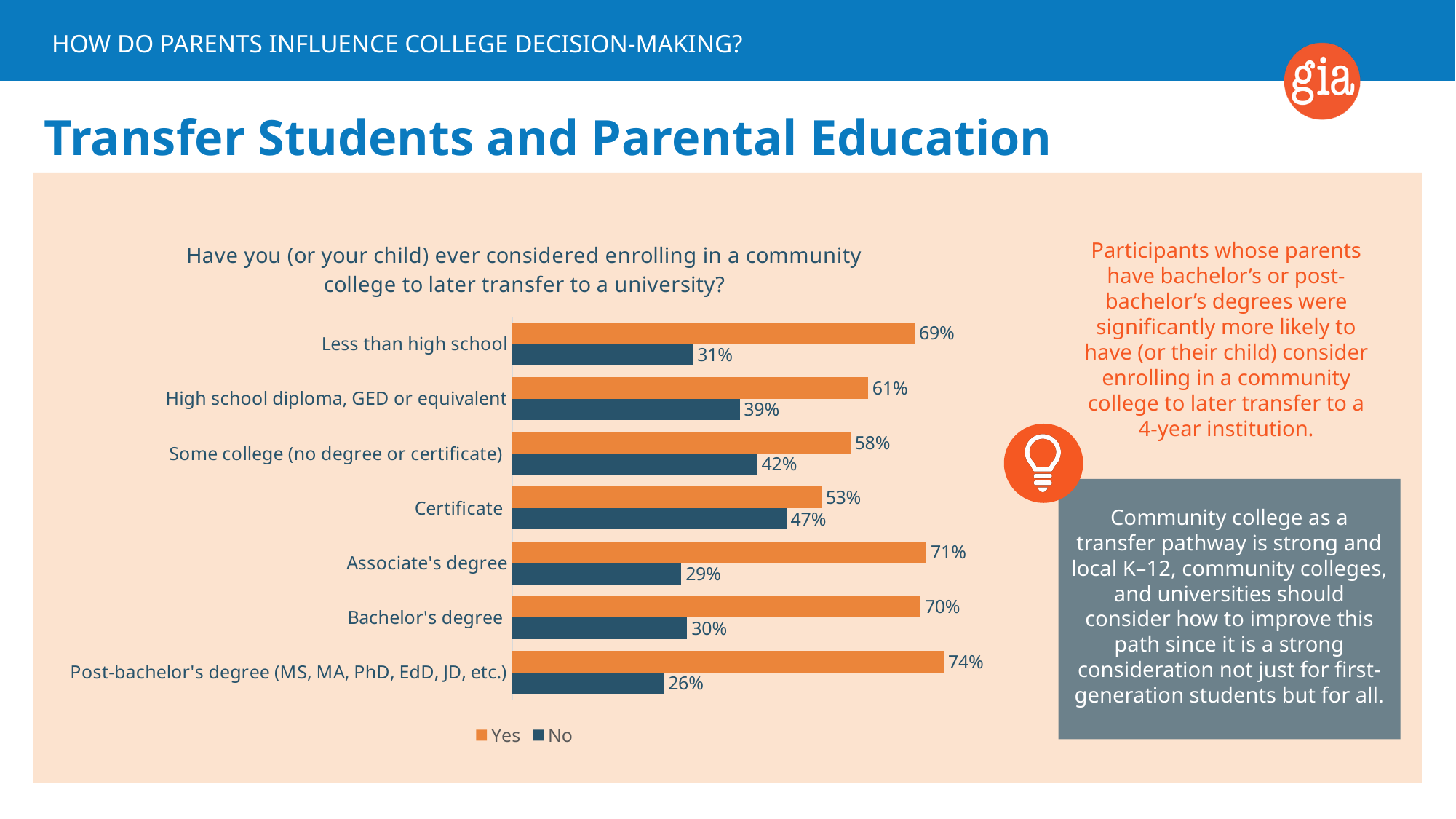
What is the Yes value for Some college (no degree or certificate)? 58% What percentage of participants whose parents have a post-bachelor's degree answered Yes? 74% Which colour represents the Yes responses in the chart? Orange Which category has the highest No value? Certificate Which parental education category has the highest Yes value? Post-bachelor's degree (MS, MA, PhD, EdD, JD, etc.) How many parental education categories are shown in the chart? 7 What is the No value for the Certificate category? 47% What type of chart is shown on the slide? Bar chart How many series does the legend list? 2 Which is larger, the Yes value for Less than high school or the Yes value for High school diploma, GED or equivalent? Less than high school What is the difference between the Yes and No values for Associate's degree? 42% Which parental education category has the lowest Yes value? Certificate